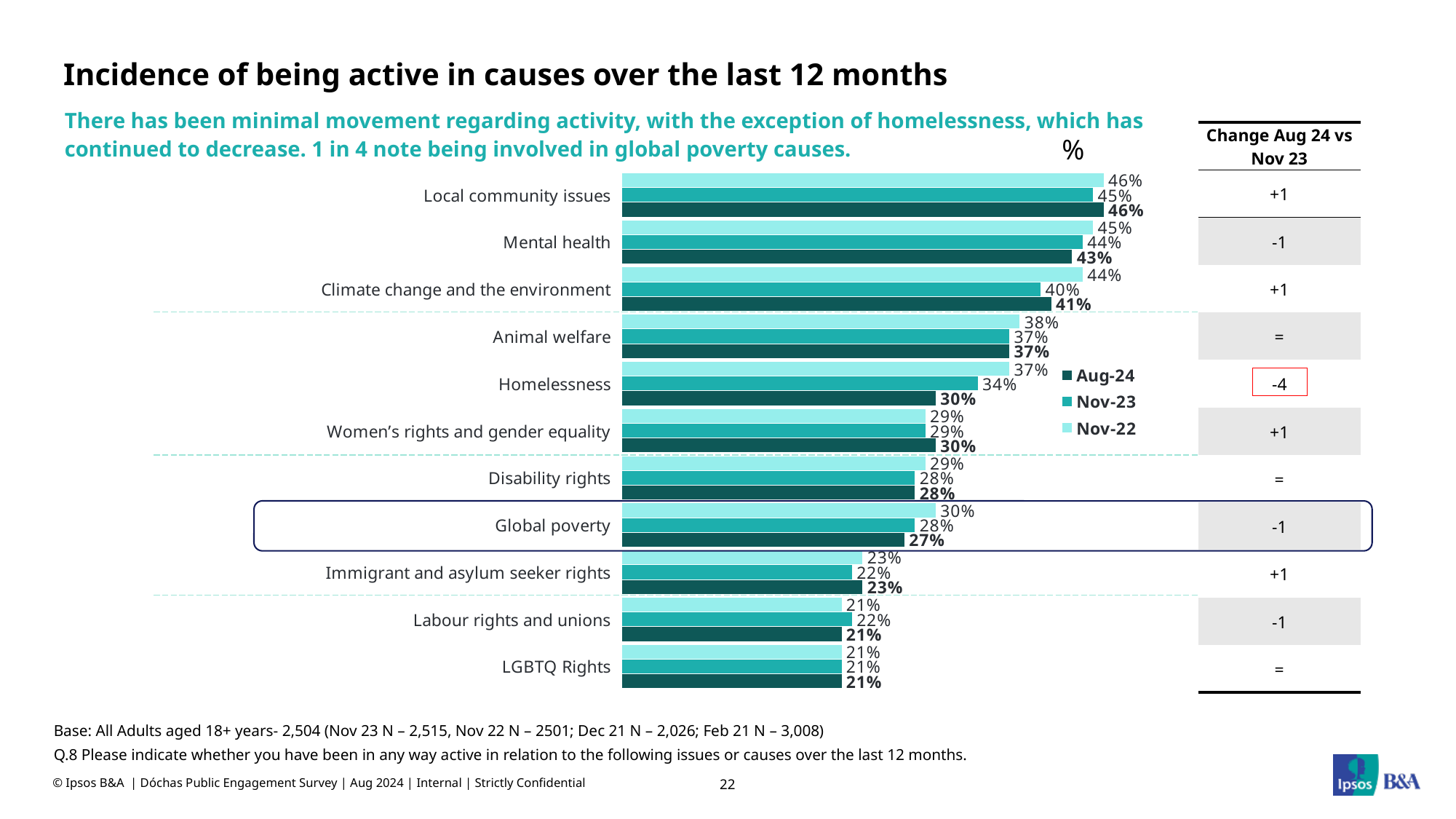
What is the Nov-23 value for Global poverty? 28% What is the Aug-24 value for Homelessness? 30% What is the Nov-22 value for Climate change and the environment? 44% Which cause has the lowest Nov-22 value? Labour rights and unions and LGBTQ Rights (both 21%) What is the change shown for Homelessness in the 'Change Aug 24 vs Nov 23' column? -4 Which series is shown in the darkest colour in the legend? Aug-24 Which cause has the highest Aug-24 value? Local community issues Which is larger for Mental health: the Nov-22 value or the Aug-24 value? Nov-22 (45%) How many causes (categories) are shown in the chart? 11 What kind of chart is shown on the slide? bar chart What is the difference between the Nov-22 and Aug-24 values for Homelessness? 7 percentage points How many series does the legend list? 3